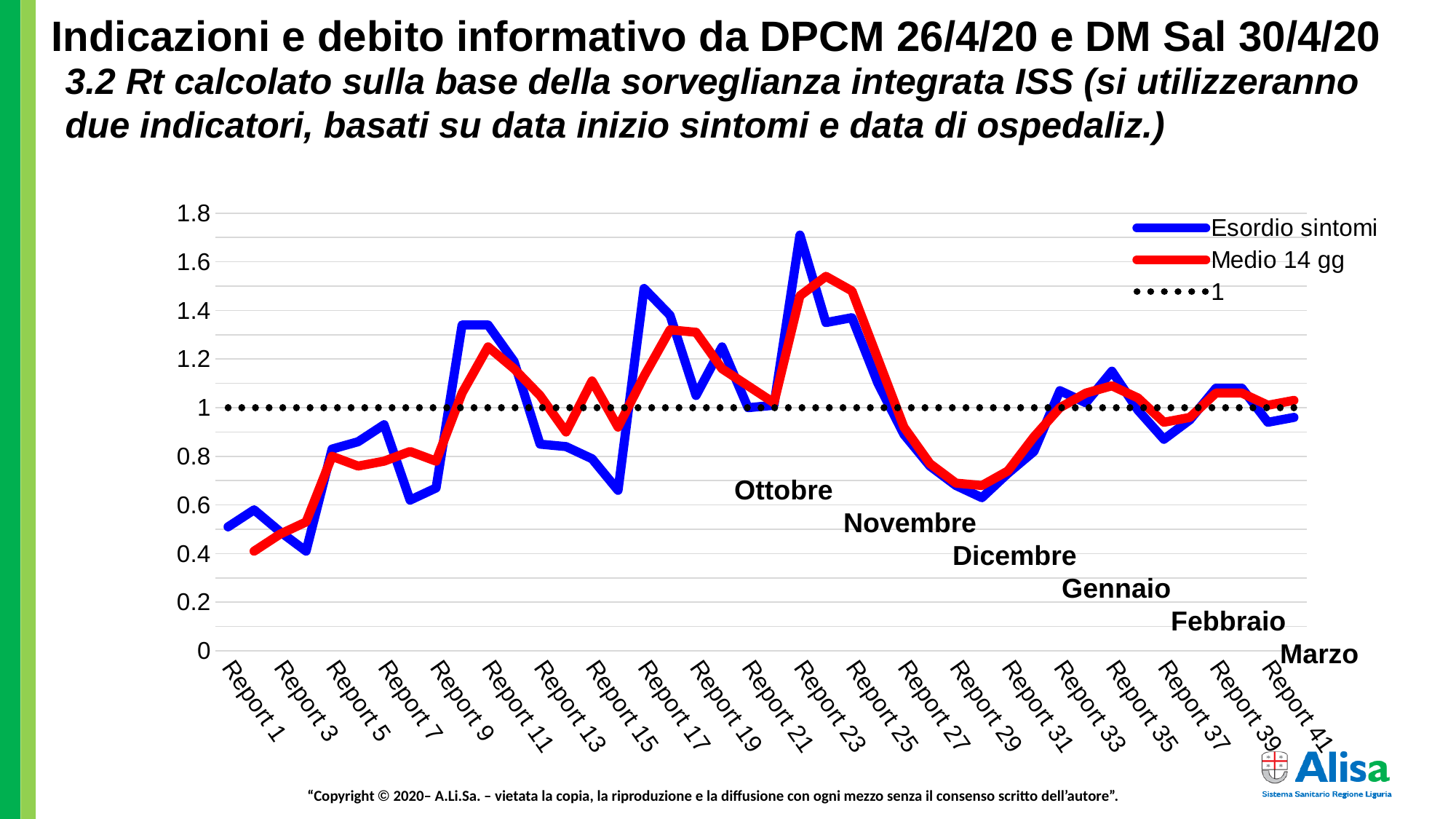
What kind of chart is shown on the slide? line chart Is the value of Esordio sintomi at Report 29 greater or less than 0.8? less Is the value of Medio 14 gg at Report 23 greater or less than 1.4? greater Does the Esordio sintomi series rise or fall between Report 23 and Report 29? fall What are the names of the two solid-line series in the legend? Esordio sintomi and Medio 14 gg Is the value of Esordio sintomi at Report 23 greater or less than 1.6? greater At Report 23, which series has the higher value, Esordio sintomi or Medio 14 gg? Esordio sintomi At which report does the Esordio sintomi series reach its highest value? Report 23 How many series does the legend list? 3 What constant value does the dotted horizontal line mark? 1 At Report 15, which series has the higher value, Esordio sintomi or Medio 14 gg? Medio 14 gg